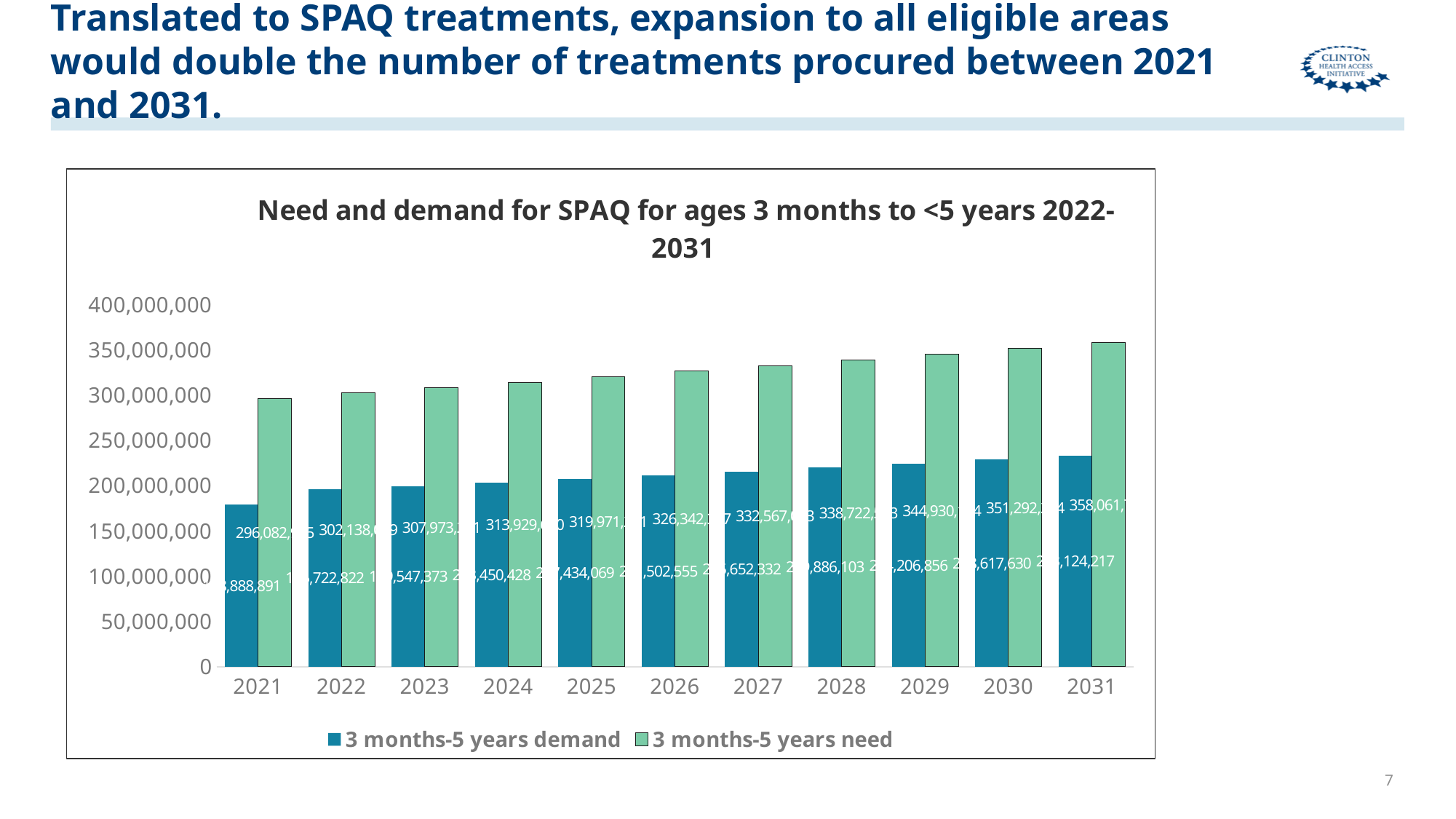
Which year has the lowest value for 3 months-5 years demand? 2021 How many series does the legend list? 2 How many years are shown on the x axis? 11 Is the value for 3 months-5 years need in 2031 greater or less than 350,000,000? greater In 2021, which is larger: 3 months-5 years demand or 3 months-5 years need? 3 months-5 years need Which year has the highest value for 3 months-5 years need? 2031 Is the value for 3 months-5 years demand in 2031 greater or less than 200,000,000? greater Do the values for 3 months-5 years need rise or fall from 2021 to 2031? rise What kind of chart is shown on the slide? Bar chart Is the value for 3 months-5 years need in 2021 greater or less than 300,000,000? less What is the title of the chart? Need and demand for SPAQ for ages 3 months to <5 years 2022-2031